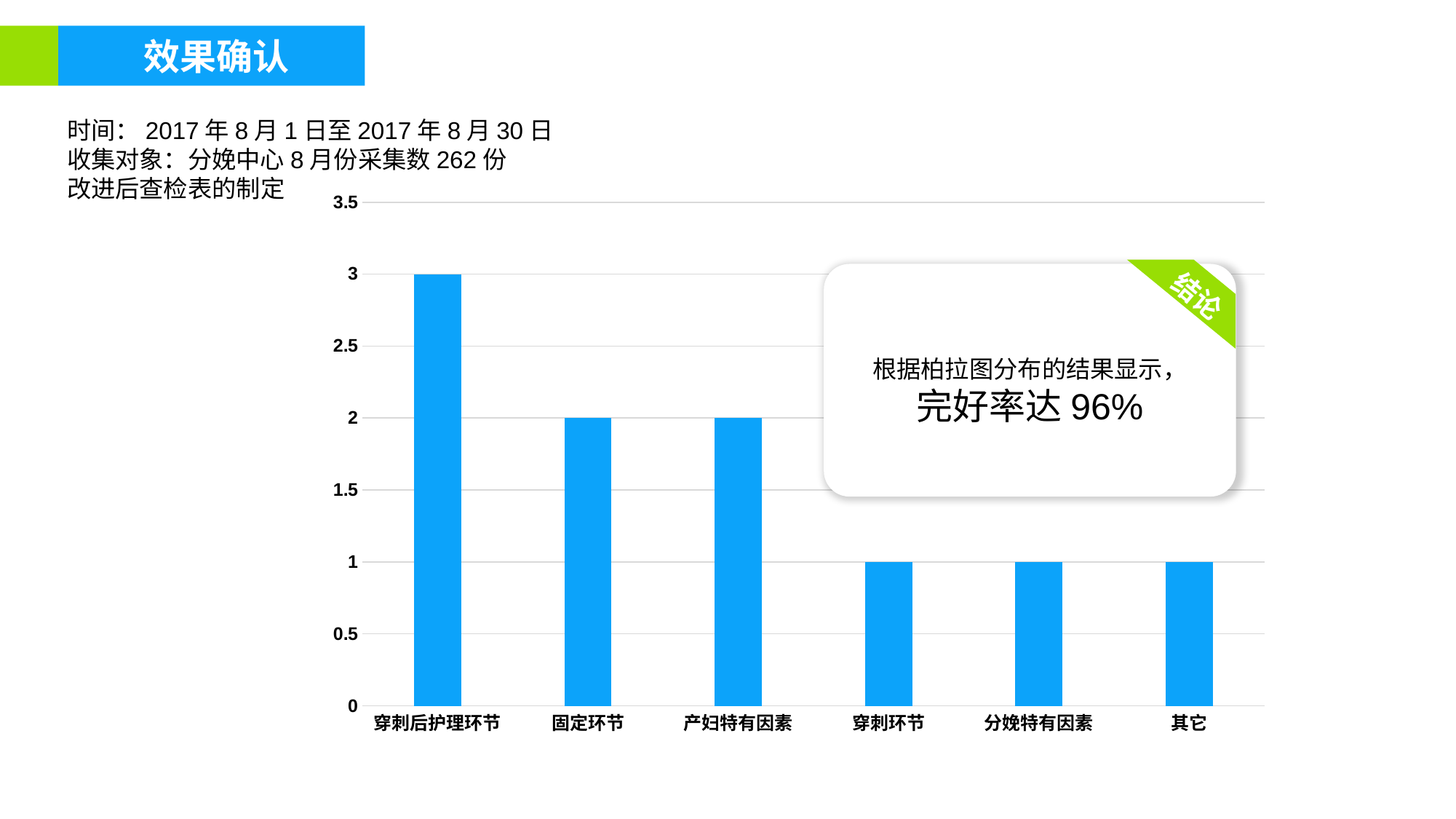
What kind of chart is shown on the slide? bar chart Is the value for 其它 greater or less than 1.5? less What is the highest value shown on the vertical axis of the chart? 3.5 What is the value for 固定环节? 2 Which is larger, the value for 固定环节 or the value for 分娩特有因素? 固定环节 What is the value for 穿刺环节? 1 What is the difference between the values for 穿刺后护理环节 and 产妇特有因素? 1 How many categories are shown on the x axis of the chart? 6 What is the value for 穿刺后护理环节? 3 Do the bar values rise or fall from left to right along the x axis? fall Is the value for 穿刺后护理环节 greater or less than 2.5? greater Which category has the highest value? 穿刺后护理环节